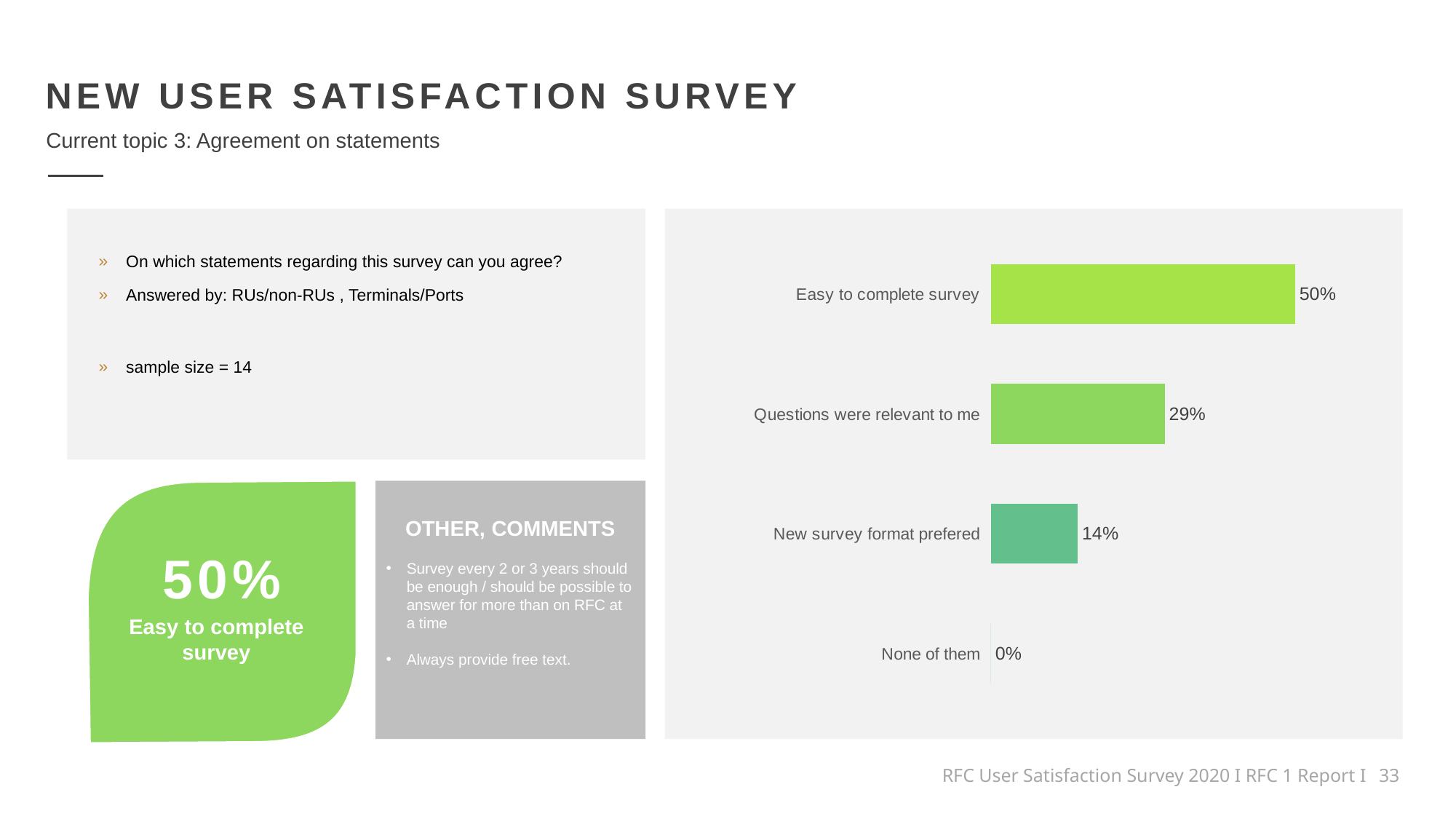
What is the value shown for "New survey format prefered"? 14% Which category has the lowest value in the chart? None of them What type of chart is shown on the slide? Bar chart What percentage of respondents agreed that the survey was easy to complete? 50% What is the difference between the values for "Easy to complete survey" and "Questions were relevant to me"? 21% What is the difference between the values for "Questions were relevant to me" and "New survey format prefered"? 15% Which is larger: the value for "Questions were relevant to me" or for "New survey format prefered"? Questions were relevant to me What is the value shown for "None of them"? 0% What is the value shown for "Questions were relevant to me"? 29% How many categories are shown in the bar chart? 4 What is the sample size stated on the slide for this chart? 14 Which statement has the highest agreement in the chart? Easy to complete survey